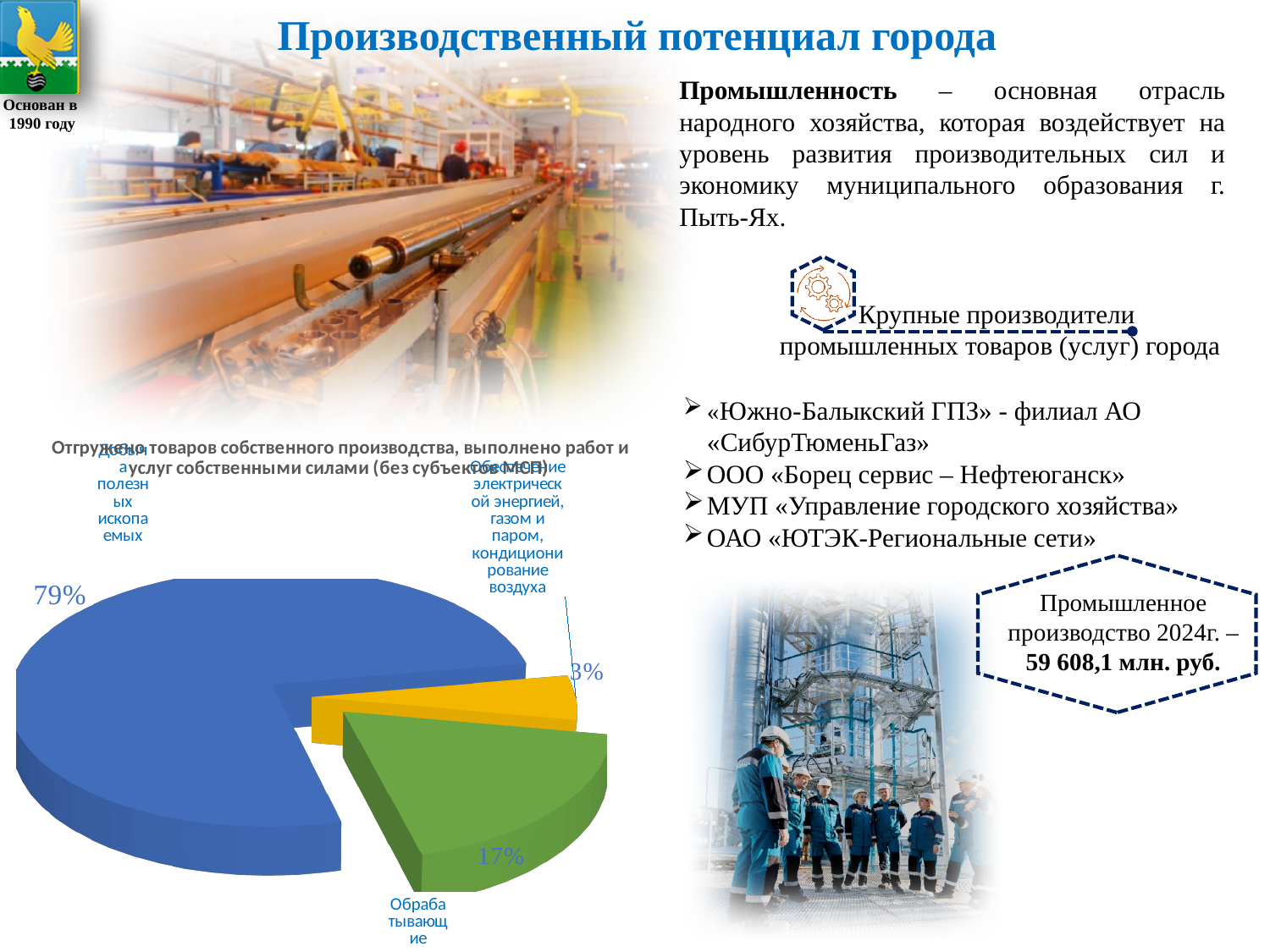
What share of the pie does «Обрабатывающие» have? 17% Which category has the largest share of the pie? Добыча полезных ископаемых What colour is the «Добыча полезных ископаемых» slice? Blue What is the difference in percentage points between the «Добыча полезных ископаемых» slice and the «Обрабатывающие» slice? 62 Which category has the smallest share of the pie? Обеспечение электрической энергией, газом и паром, кондиционирование воздуха What colour is the «Обрабатывающие» slice? Green Which is larger: the share for «Обрабатывающие» or the share for «Обеспечение электрической энергией, газом и паром, кондиционирование воздуха»? Обрабатывающие What share of the pie does «Добыча полезных ископаемых» have? 79% What share of the pie does «Обеспечение электрической энергией, газом и паром, кондиционирование воздуха» have? 3% How many slices does the pie chart have? 3 What kind of chart is shown on the slide? Pie chart